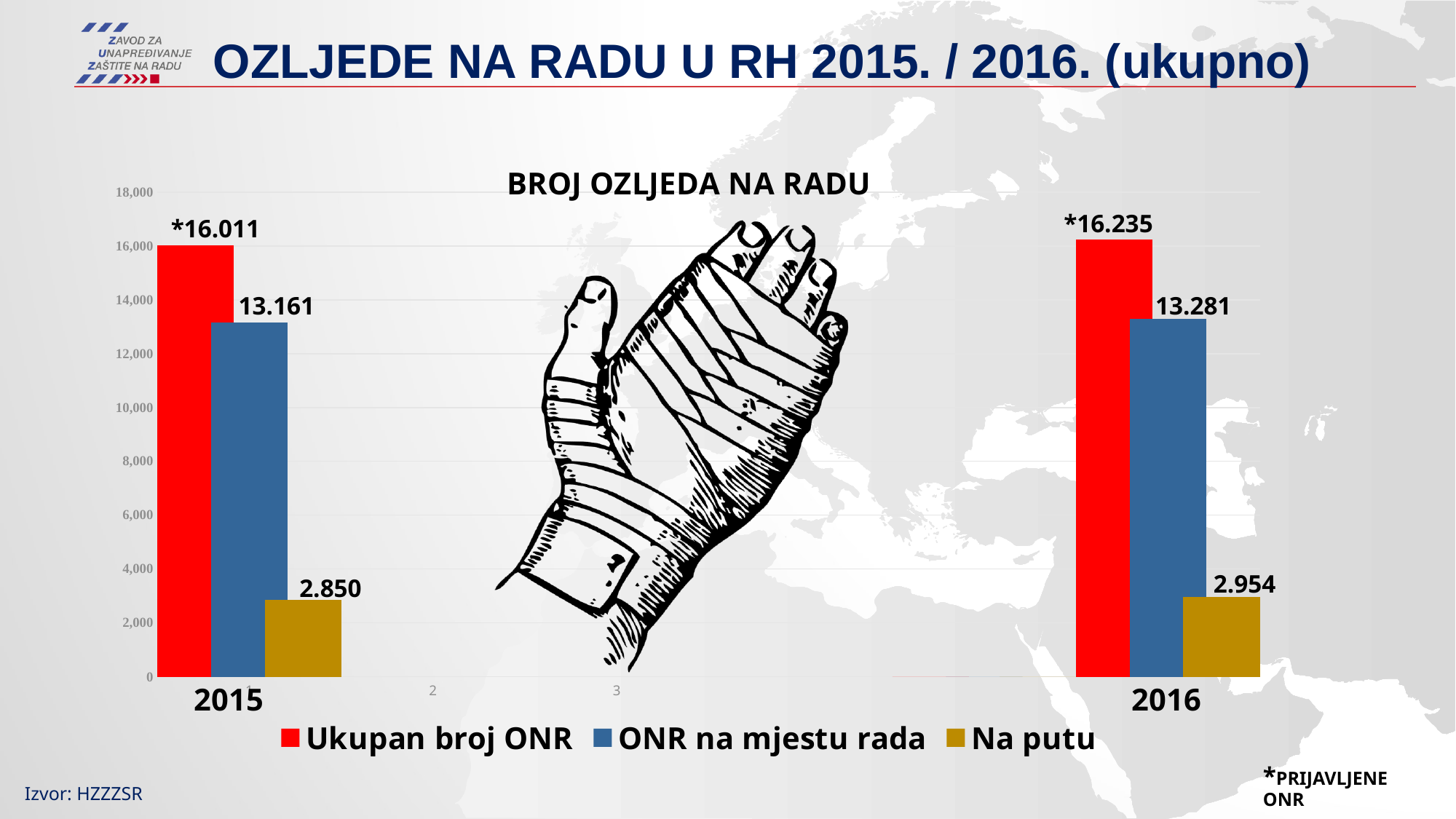
How many series does the legend list? 3 What is the title of the chart? BROJ OZLJEDA NA RADU What is the value of Na putu for 2016? 2.954 Is the value of Na putu for 2016 greater or less than ONR na mjestu rada for 2016? less Which year has the higher value for Ukupan broj ONR? 2016 What is the value of Ukupan broj ONR for 2015? 16.011 What is the value of Na putu for 2015? 2.850 Which series has the lowest value in 2015? Na putu What is the difference between Ukupan broj ONR in 2016 and in 2015? 224 What is the difference between ONR na mjestu rada in 2016 and in 2015? 120 What kind of chart is shown on the slide? bar chart What is the value of ONR na mjestu rada for 2016? 13.281